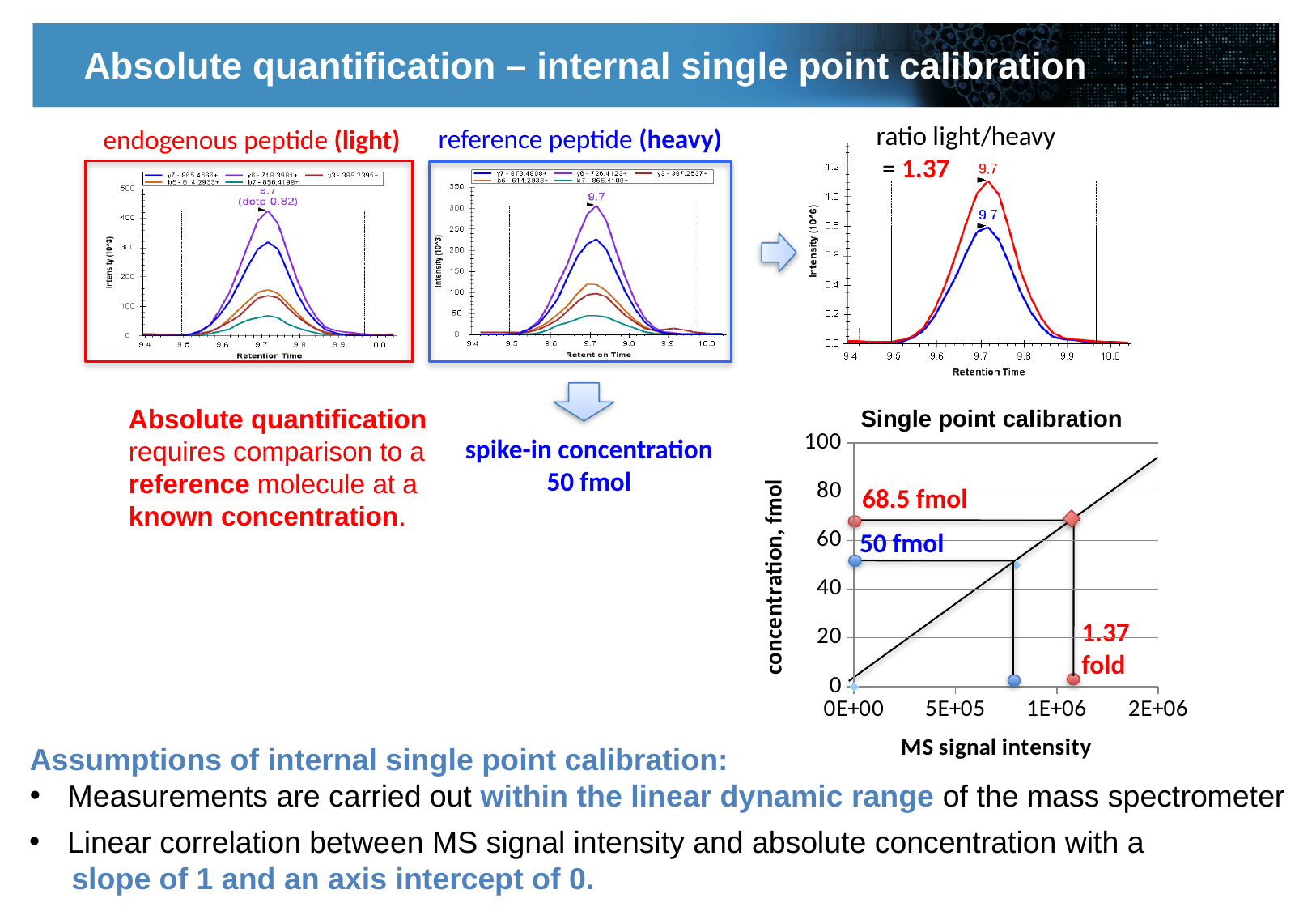
In the 'Single point calibration' chart, is the MS signal intensity of the blue point greater or less than 5E+05? greater In the 'ratio light/heavy' chart at the top right, which curve reaches the higher peak intensity, the red or the blue? red What is the y-axis label of the 'Single point calibration' chart? concentration, fmol In the 'Single point calibration' chart, is the MS signal intensity of the blue point greater or less than 1E+06? less In the 'Single point calibration' chart, which labelled point has the higher concentration, the red point or the blue point? the red point (68.5 fmol) In the 'Single point calibration' chart, what fold difference is annotated between the two points? 1.37 fold What is the x-axis label of the 'Single point calibration' chart? MS signal intensity In the 'Single point calibration' chart, what concentration is labelled for the blue (reference) point? 50 fmol In the 'ratio light/heavy' chart at the top right, what ratio value is stated? 1.37 In the 'Single point calibration' chart, what concentration is labelled for the red (endogenous) point? 68.5 fmol In the 'Single point calibration' chart, what is the difference between the two labelled concentrations, 68.5 fmol and 50 fmol? 18.5 fmol In the 'ratio light/heavy' chart at the top right, at what retention time do the peaks occur? 9.7